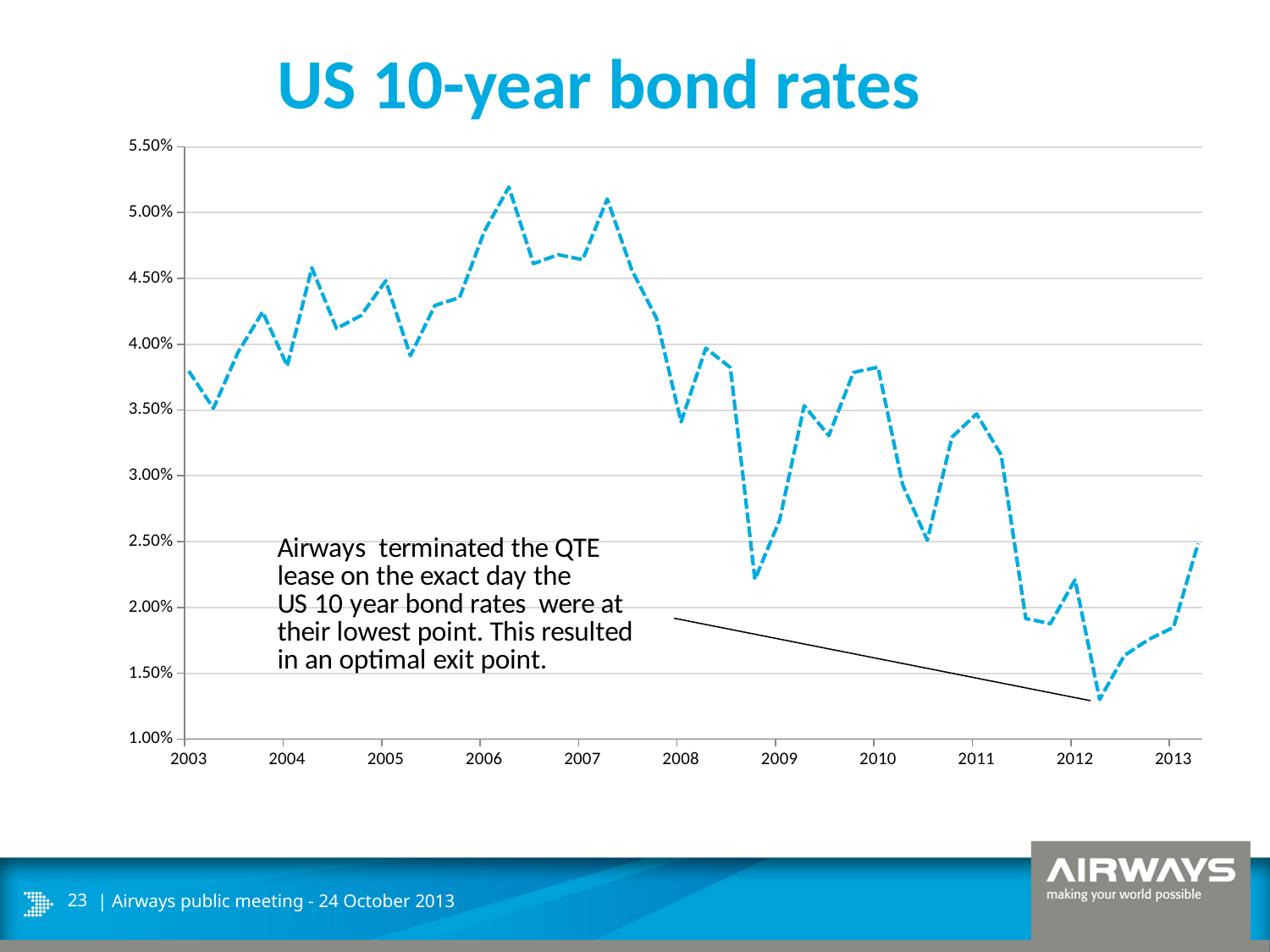
How many year labels are shown on the x axis? 11 Is the lowest bond rate, reached in 2012, greater or less than 1.50%? less What kind of chart is shown on the slide? line chart Is the bond rate higher at the start of 2006 or at the start of 2012? 2006 Around which year does the bond rate reach its lowest point? 2012 Around which year does the bond rate reach its highest point? 2006 Is the bond rate at the start of 2007 greater or less than 4.50%? greater Is the bond rate at the start of 2013 greater or less than 2.50%? less Overall, do the US 10-year bond rates rise or fall from 2003 to 2013? fall What is the title of the chart? US 10-year bond rates